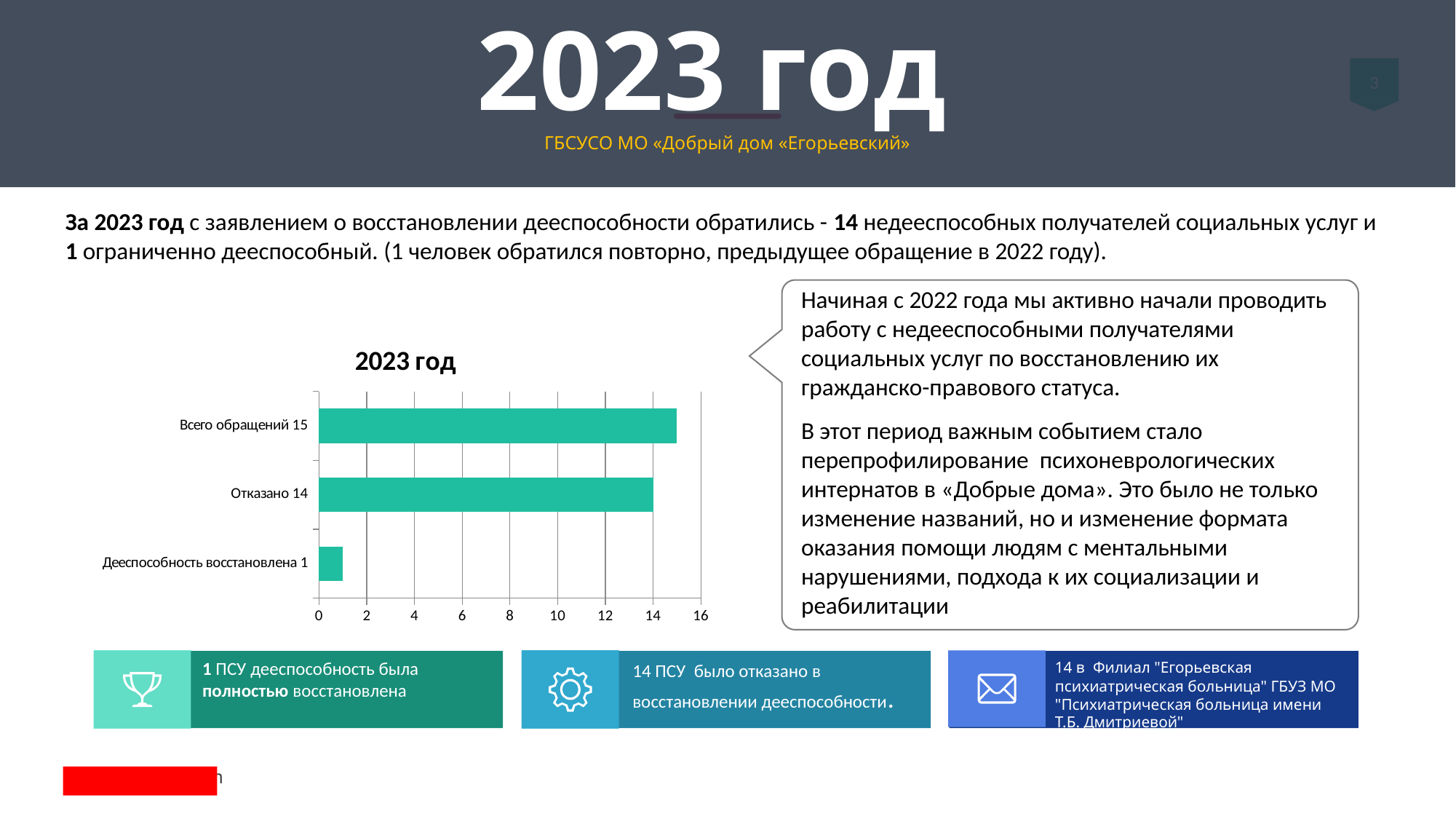
What is the difference between «Отказано» and «Дееспособность восстановлена»? 13 Which category has the lowest value in the chart? Дееспособность восстановлена What is the difference between «Всего обращений» and «Отказано»? 1 Which is larger: «Отказано» or «Дееспособность восстановлена»? Отказано What is the value for «Отказано» in the chart? 14 What is the value for «Дееспособность восстановлена» in the chart? 1 How many categories are shown in the chart? 3 What kind of chart is shown on the slide? bar chart What is the value for «Всего обращений» in the chart? 15 What is the title of the chart? 2023 год Is the value for «Отказано» greater or less than 10? greater Which category has the highest value in the chart? Всего обращений